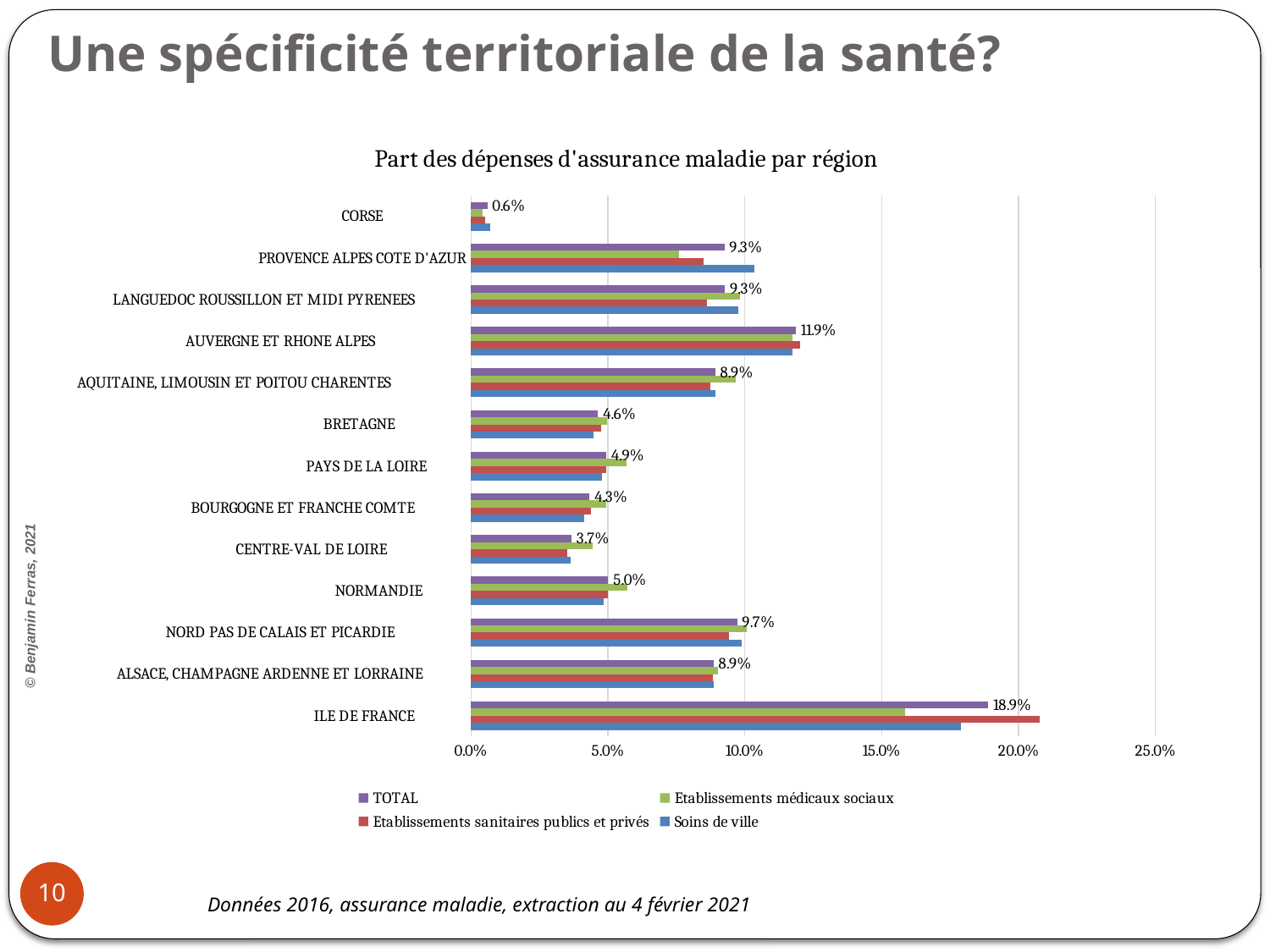
What is the TOTAL value for AUVERGNE ET RHONE ALPES? 11.9% Which region has the highest TOTAL value? ILE DE FRANCE Which region has the lowest TOTAL value? CORSE What is the title of the chart? Part des dépenses d'assurance maladie par région What is the TOTAL value for ILE DE FRANCE? 18.9% Which has a larger TOTAL value, NORD PAS DE CALAIS ET PICARDIE or BRETAGNE? NORD PAS DE CALAIS ET PICARDIE What kind of chart is shown on the slide? Bar chart What is the TOTAL value for CENTRE-VAL DE LOIRE? 3.7% What is the difference between the TOTAL values for ILE DE FRANCE and AUVERGNE ET RHONE ALPES? 7.0% How many regions are shown on the chart? 13 Is the Soins de ville value for ILE DE FRANCE greater or less than 15.0%? greater How many series does the legend list? 4